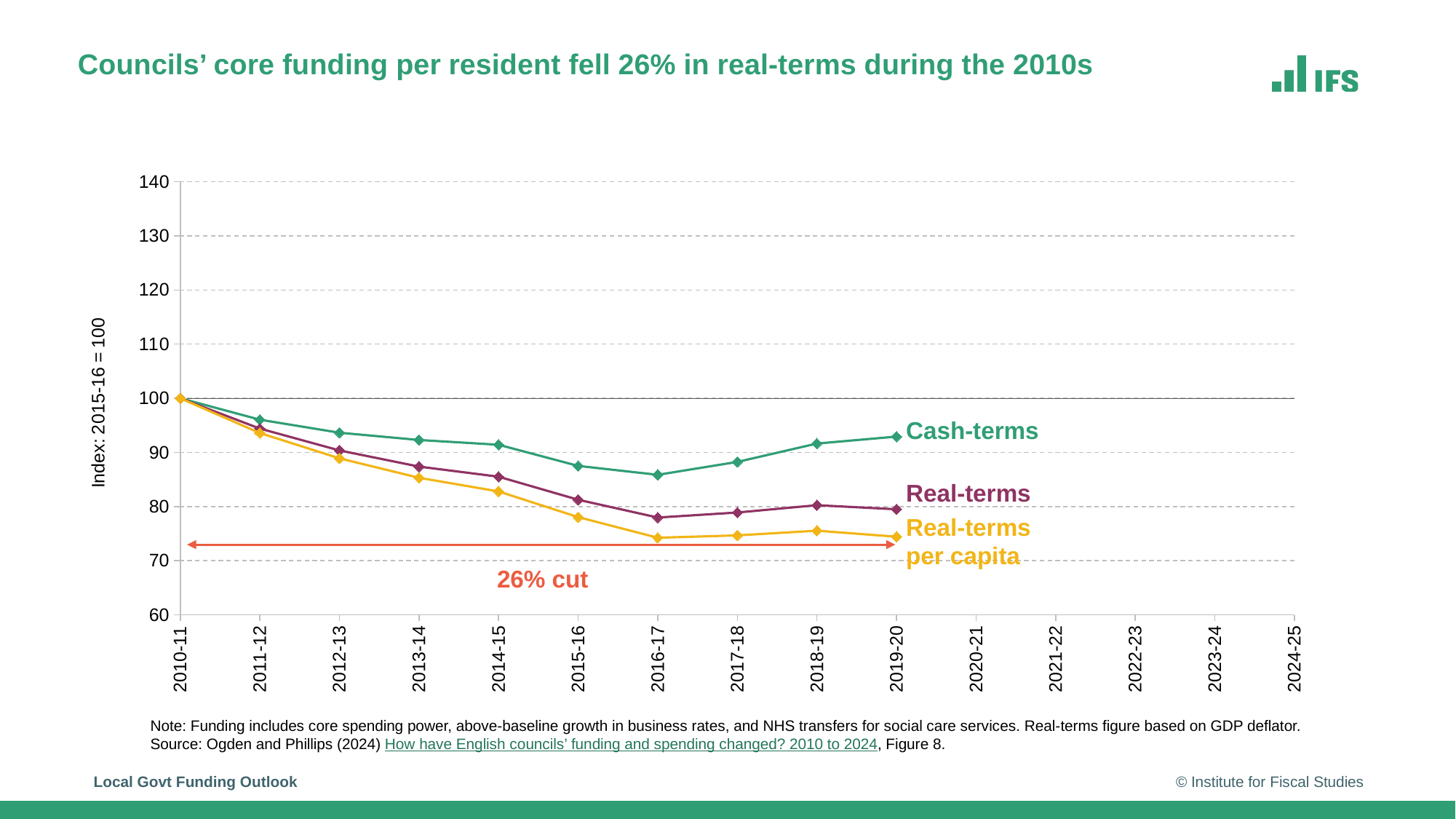
Is the value for Cash-terms in 2019-20 greater or less than 90? greater What kind of chart is shown on the slide? line chart In 2019-20, which series is higher, Cash-terms or Real-terms? Cash-terms How many series are plotted on the chart? 3 What percentage cut is labelled by the red arrow on the chart? 26% cut What is the value of the Cash-terms series in 2010-11? 100 In which year does the Cash-terms series reach its lowest value? 2016-17 Is the value for Real-terms per capita in 2019-20 greater or less than 80? less Is the value for Real-terms per capita in 2014-15 greater or less than 80? greater Does the Cash-terms series rise or fall between 2010-11 and 2016-17? fall What is the value of the Real-terms per capita series in 2010-11? 100